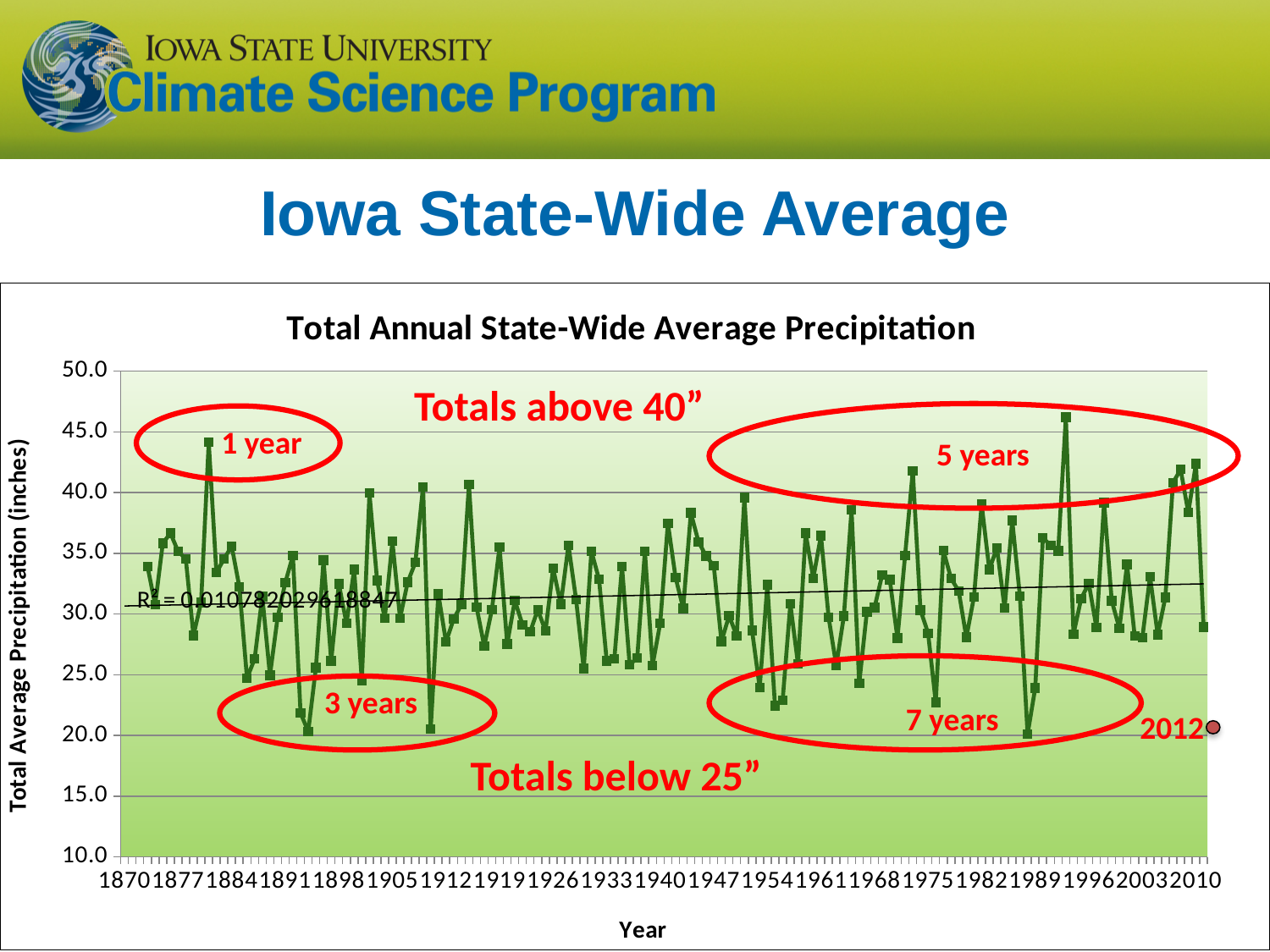
What is the label on the vertical axis of the chart? Total Average Precipitation (inches) Is the value for 2012 greater or less than 25? less Does the fitted trend line rise or fall from 1870 to 2012? rises slightly Is the value for 1877 greater or less than 30? greater What kind of chart is shown on the slide? line chart What is the title of the chart? Total Annual State-Wide Average Precipitation Is the highest value plotted on the chart greater or less than 45? greater According to the annotations, how many years in total had totals above 40 inches? 6 According to the annotations, how many years in total had totals below 25 inches? 10